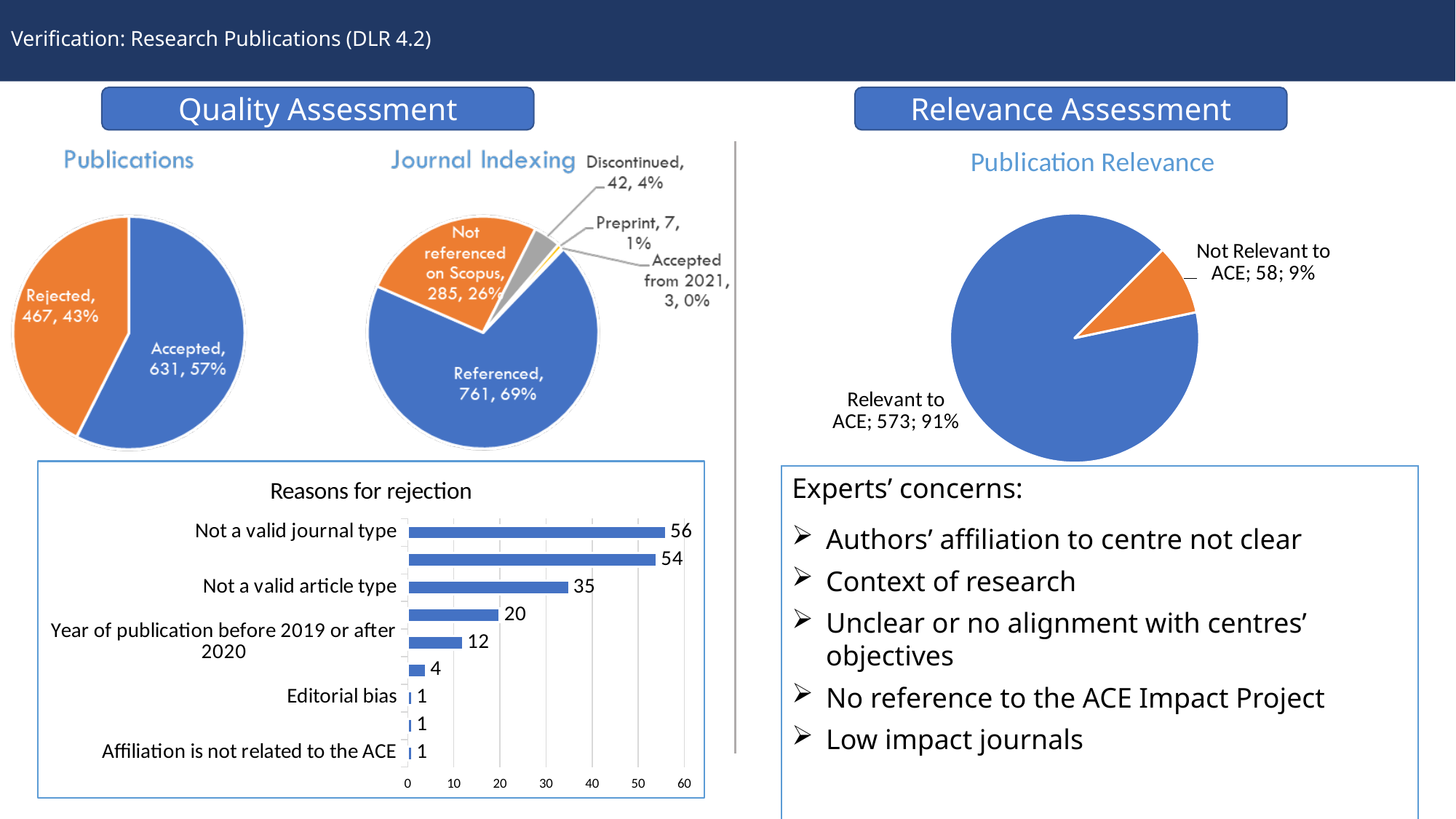
In the Journal Indexing pie chart, how many publications were Referenced? 761 What kind of chart is the Reasons for rejection chart? bar chart In the Publications pie chart, how many publications were Accepted? 631 In the Journal Indexing pie chart, what share of publications were Not referenced on Scopus? 26% In the Publication Relevance pie chart, how many publications were Relevant to ACE? 573 In the Publications pie chart, what share of publications were Rejected? 43% In the Journal Indexing pie chart, which category has the smallest value? Accepted from 2021 In the Reasons for rejection chart, what is the value for Not a valid journal type? 56 How many slices does the Journal Indexing pie chart have? 5 In the Publication Relevance pie chart, what share of publications were Not Relevant to ACE? 9% In the Publications pie chart, what is the difference between the number of Accepted and Rejected publications? 164 In the Reasons for rejection chart, what is the value for Not a valid article type? 35